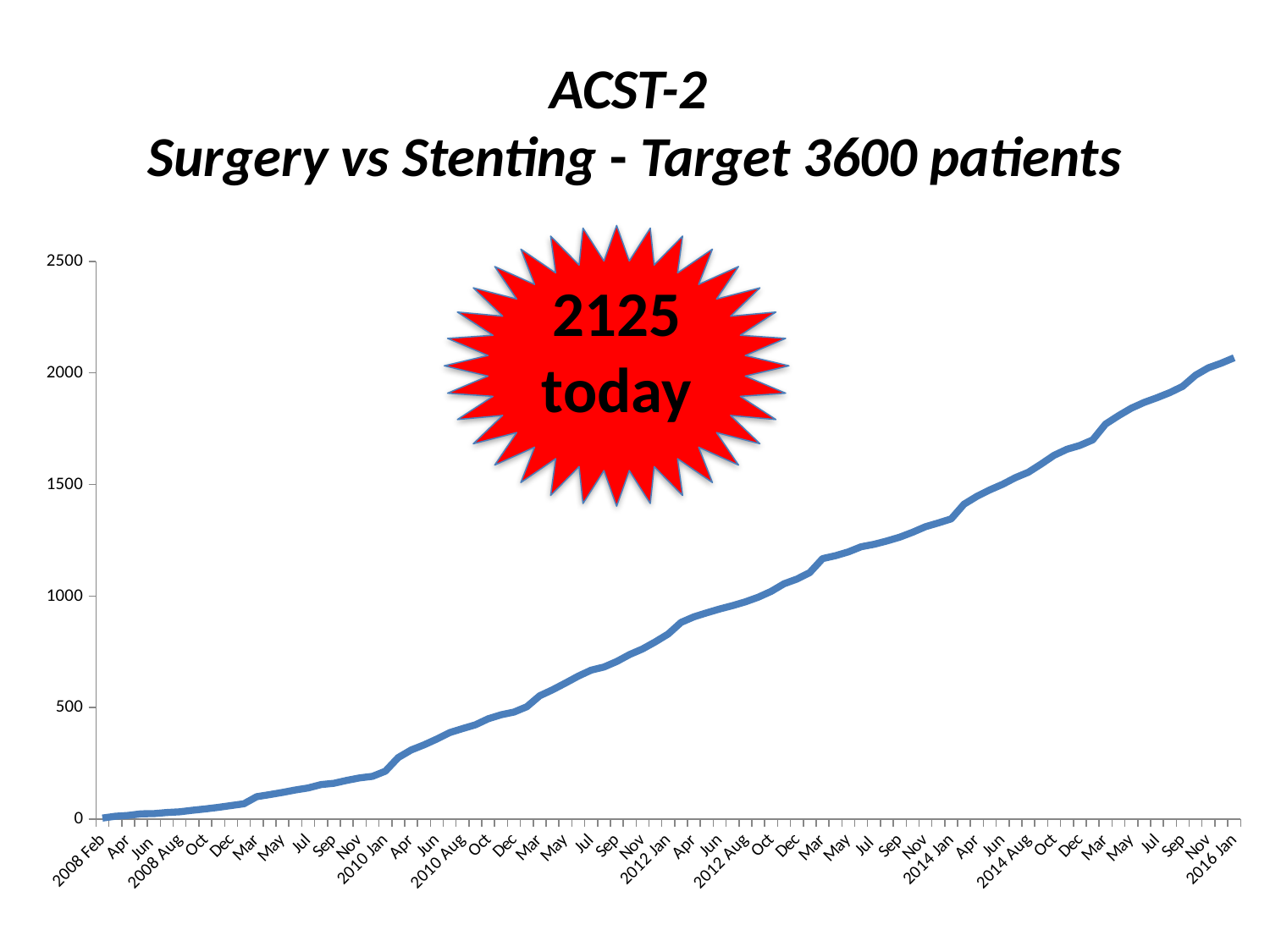
What kind of chart is shown on the slide? line chart Is the value at 2014 Jan greater or less than 1000? greater Is the value at 2014 Jan greater or less than 1500? less What is the target number of patients stated in the slide title? 3600 Which is larger, the value at 2012 Jan or the value at 2014 Jan? 2014 Jan Which point on the x axis has the highest value? 2016 Jan What number is shown in the red starburst on the chart? 2125 Is the value at 2010 Jan greater or less than 500? less Which point on the x axis has the lowest value? 2008 Feb Do the values rise or fall along the x axis from 2008 Feb to 2016 Jan? rise